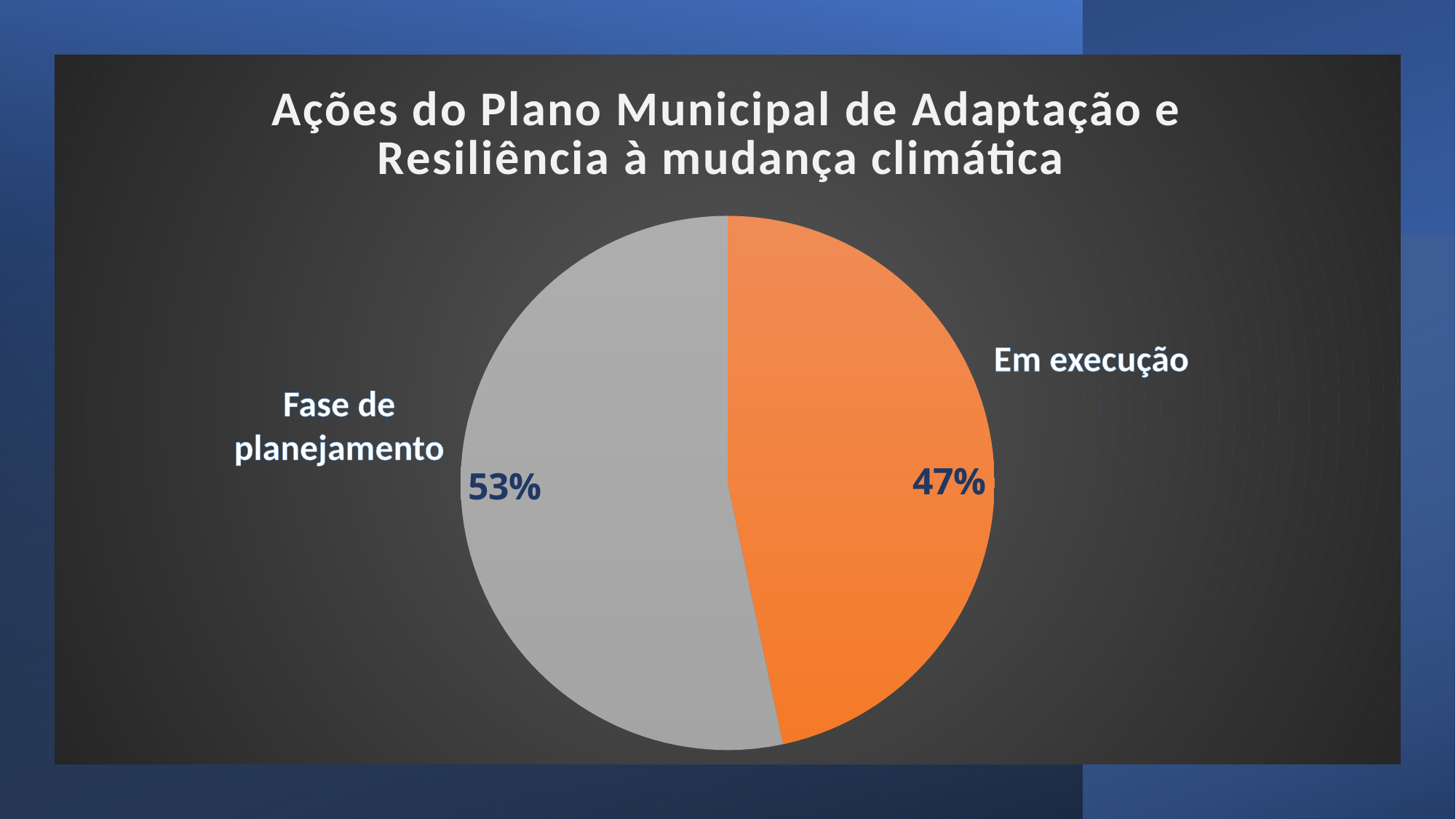
What is the difference in percentage points between 'Fase de planejamento' and 'Em execução'? 6 Which slice is the largest? Fase de planejamento What colour is the 'Em execução' slice? orange What percentage of actions are in the 'Fase de planejamento'? 53% How many slices does the pie chart have? 2 Which slice is the smallest? Em execução What is the title of the chart? Ações do Plano Municipal de Adaptação e Resiliência à mudança climática What kind of chart is shown on the slide? pie chart Which is larger, 'Fase de planejamento' or 'Em execução'? Fase de planejamento What percentage of actions are 'Em execução'? 47% What share of the pie does 'Em execução' represent? 47%